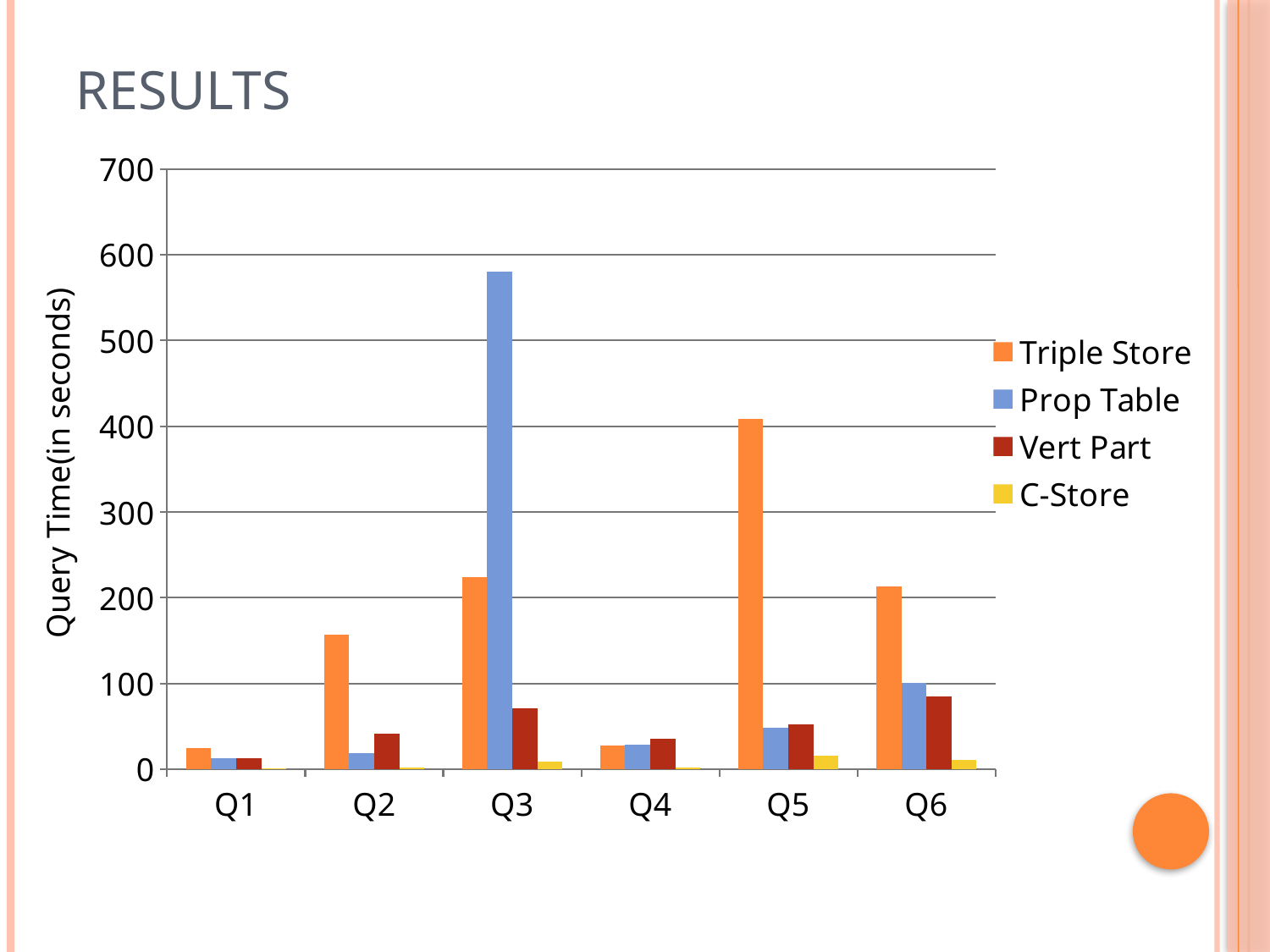
Is the Triple Store value for Q2 greater or less than 100? greater Is the Prop Table value for Q3 greater or less than 500? greater How many series does the legend list? 4 For which query is the Triple Store bar the highest? Q5 What is the label on the y axis? Query Time(in seconds) Which series has the lowest value for Q6? C-Store Is the Triple Store value for Q5 greater or less than 300? greater For which query is the Prop Table bar the highest? Q3 How many queries are shown along the x axis? 6 For Q2, which is larger: the Triple Store value or the Vert Part value? Triple Store For Q3, which is larger: the Prop Table value or the Triple Store value? Prop Table What kind of chart is shown on the slide? bar chart